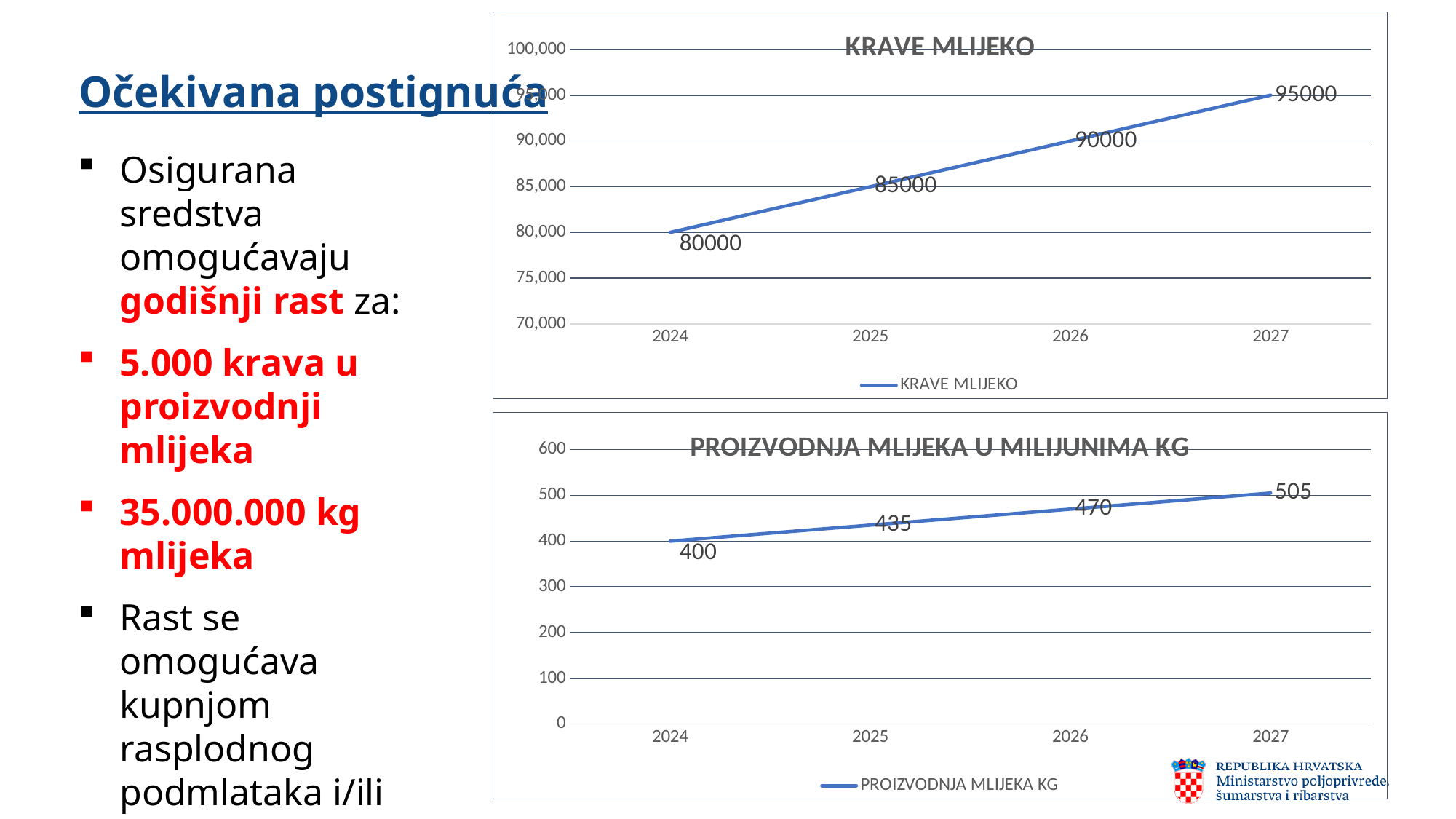
In the PROIZVODNJA MLIJEKA U MILIJUNIMA KG chart, how many series does the legend list? 1 In the KRAVE MLIJEKO chart, what is the value for 2027? 95000 In the KRAVE MLIJEKO chart, which year has the highest value? 2027 In the PROIZVODNJA MLIJEKA U MILIJUNIMA KG chart, what is the value for 2025? 435 In the KRAVE MLIJEKO chart, how many years are plotted? 4 In the KRAVE MLIJEKO chart, what is the value for 2024? 80000 What kind of chart is the PROIZVODNJA MLIJEKA U MILIJUNIMA KG chart? line chart In the PROIZVODNJA MLIJEKA U MILIJUNIMA KG chart, what is the value for 2027? 505 In the PROIZVODNJA MLIJEKA U MILIJUNIMA KG chart, what is the difference between the values for 2027 and 2024? 105 In the PROIZVODNJA MLIJEKA U MILIJUNIMA KG chart, which year has the lowest value? 2024 In the KRAVE MLIJEKO chart, do the values rise or fall from 2024 to 2027? rise In the KRAVE MLIJEKO chart, what is the difference between the values for 2026 and 2025? 5000